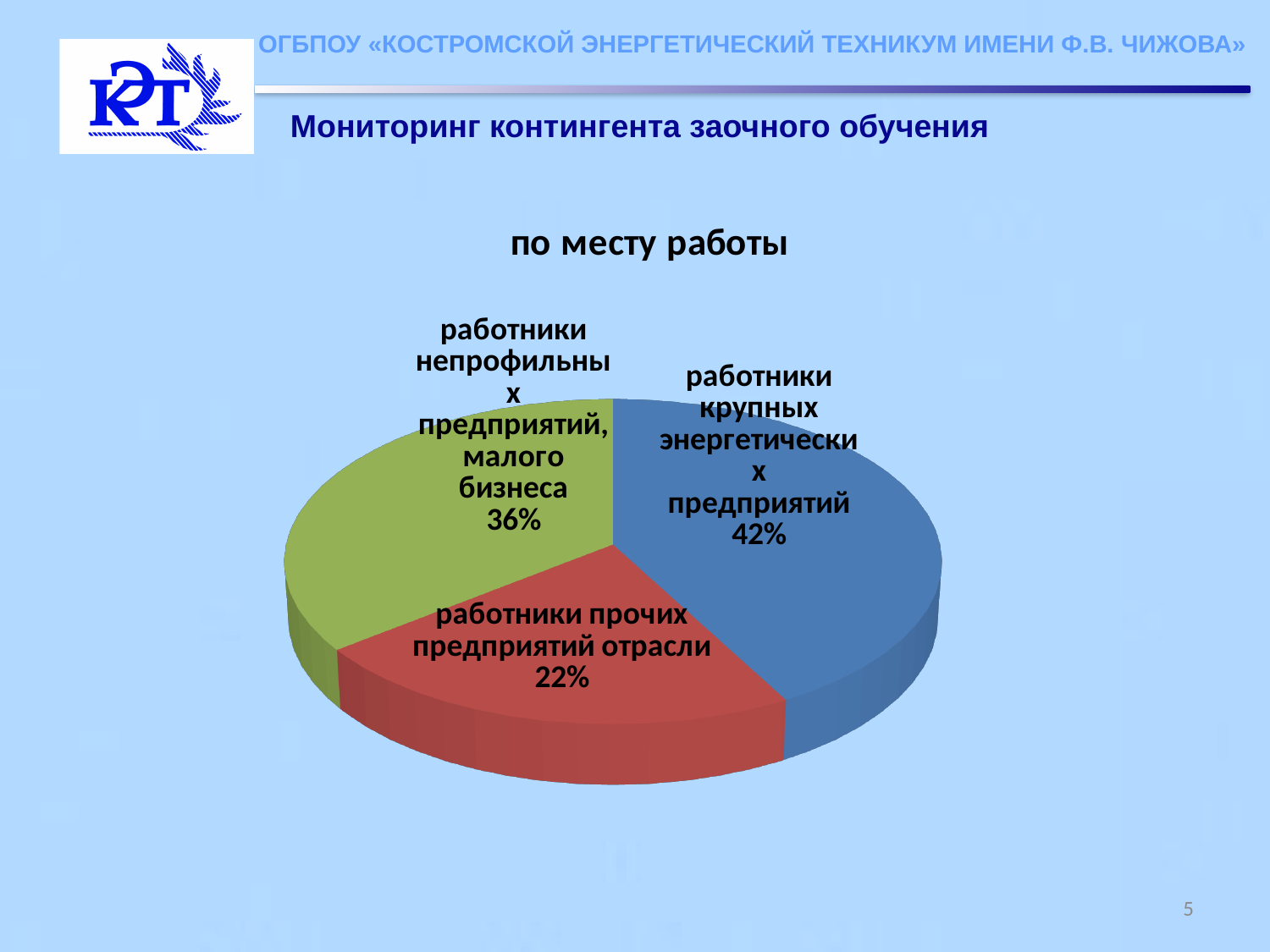
What share of the pie is 'работники крупных энергетических предприятий'? 42% What share of the pie is 'работники прочих предприятий отрасли'? 22% Which category has the largest share of the pie? работники крупных энергетических предприятий What kind of chart is shown on the slide? pie chart What is the difference in percentage points between 'работники крупных энергетических предприятий' and 'работники прочих предприятий отрасли'? 20% What is the difference in percentage points between 'работники крупных энергетических предприятий' and 'работники непрофильных предприятий, малого бизнеса'? 6% Which is larger: the share for 'работники непрофильных предприятий, малого бизнеса' or for 'работники прочих предприятий отрасли'? работники непрофильных предприятий, малого бизнеса What colour is the slice for 'работники прочих предприятий отрасли'? red How many slices does the pie chart have? 3 What share of the pie is 'работники непрофильных предприятий, малого бизнеса'? 36% What is the title of the chart? по месту работы Which category has the smallest share of the pie? работники прочих предприятий отрасли